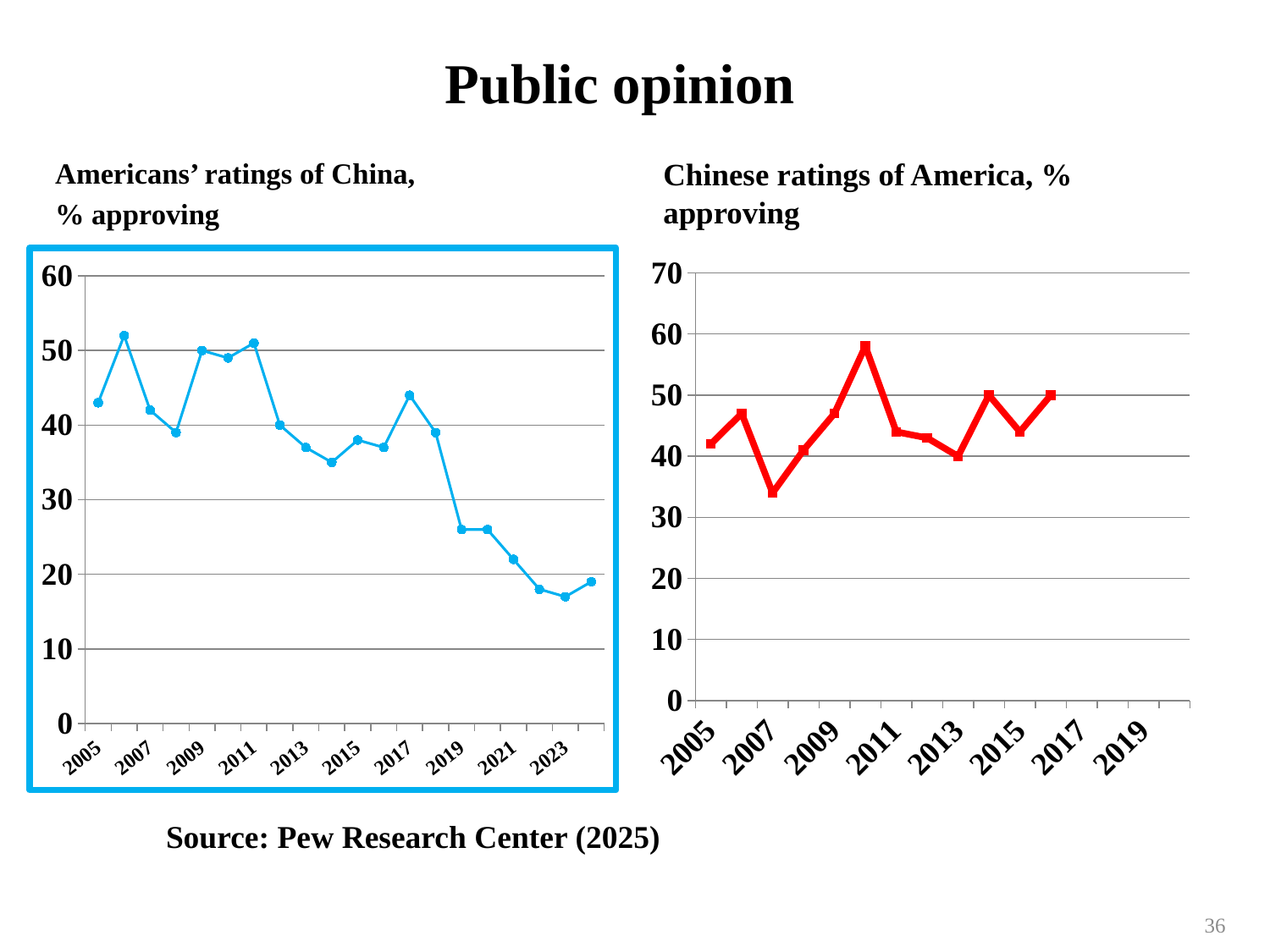
In the 'Americans' ratings of China' chart, is the value for 2023 greater or less than 20? less In the 'Americans' ratings of China' chart, what is the value for 2009? 50 In the 'Americans' ratings of China' chart, do the values overall rise or fall from 2005 to the end of the series? fall What colour is the line in the 'Chinese ratings of America' chart? red What source is cited for the charts on the slide? Pew Research Center (2025) In the 'Chinese ratings of America' chart, is the value for 2009 greater or less than 40? greater In the 'Chinese ratings of America' chart, is the value for 2007 greater or less than 40? less In the 'Americans' ratings of China' chart, which is larger, the value for 2005 or the value for 2019? 2005 What kind of chart is the 'Chinese ratings of America, % approving' chart? line chart In the 'Chinese ratings of America' chart, which is larger, the value for 2007 or the value for 2009? 2009 What kind of chart is the 'Americans' ratings of China, % approving' chart? line chart